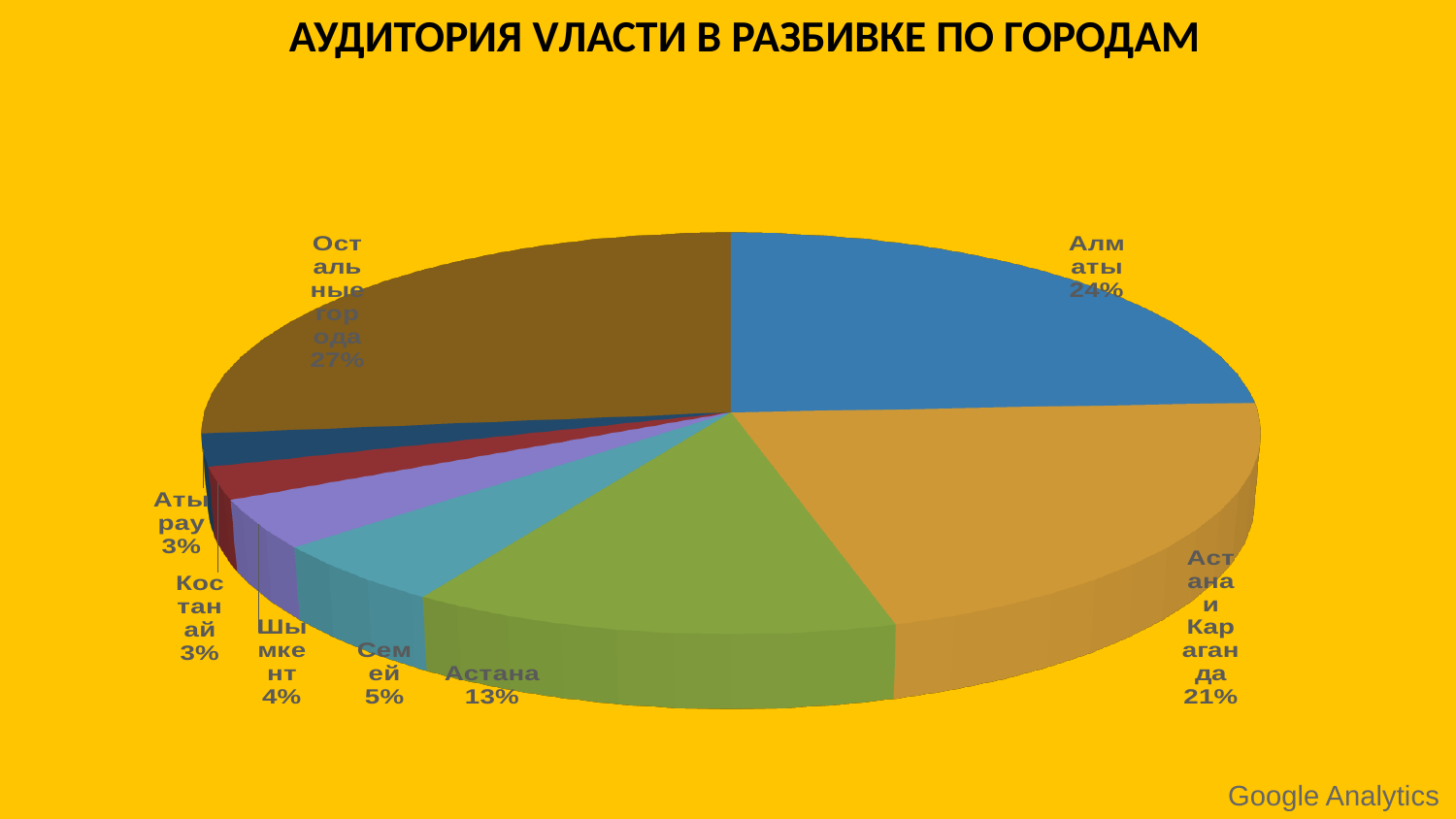
What percentage is shown for Остальные города? 27% What is the difference in percentage points between Алматы and Астана? 11 What percentage is shown for Астана? 13% Which slice of the pie is the largest? Остальные города Which is larger, the share for Семей or the share for Шымкент? Семей What is the title of the chart? АУДИТОРИЯ VЛАСТИ В РАЗБИВКЕ ПО ГОРОДАМ What share is shown for Шымкент? 4% What kind of chart is shown on the slide? pie chart What share is shown for Семей? 5% What share of the audience does Алматы account for? 24% How many slices does the pie chart have? 8 What percentage is shown for Астана и Караганда? 21%